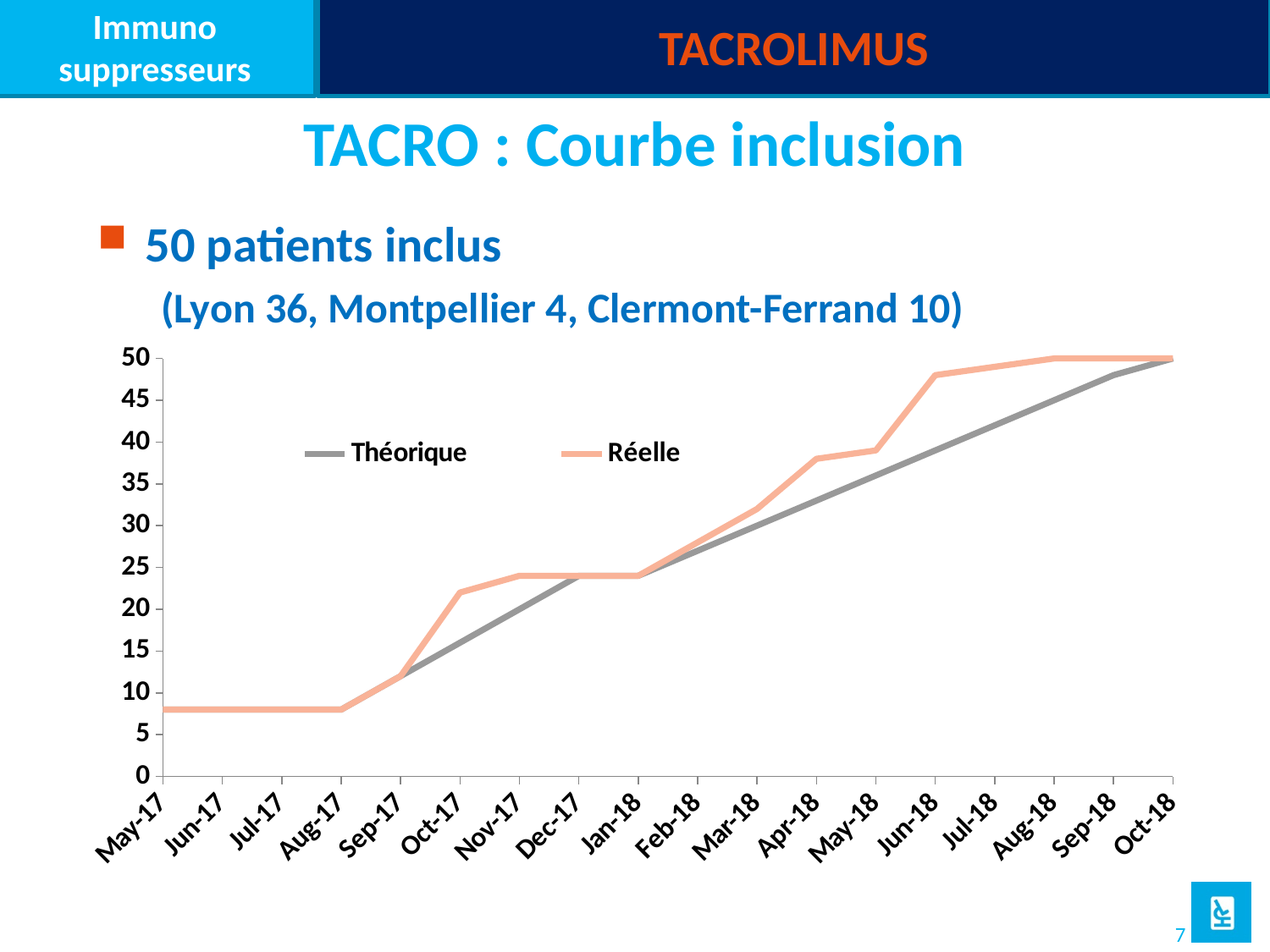
How many series does the chart legend list? 2 Is the value of the Réelle series at May-17 greater or less than 10? less Is the value of the Théorique series at Apr-18 greater or less than 35? less How many months are shown on the x axis of the chart? 18 What is the value of the Réelle series at Oct-18? 50 What is the value of the Théorique series at Oct-18? 50 Do the values of the Théorique series rise or fall from May-17 to Oct-18? rise What is the value of the Réelle series at Aug-18? 50 At Jun-18, which series has the higher value, Théorique or Réelle? Réelle What kind of chart is shown on the slide? line chart Is the value of the Réelle series at Jun-18 greater or less than 45? greater What are the two series named in the chart legend? Théorique and Réelle